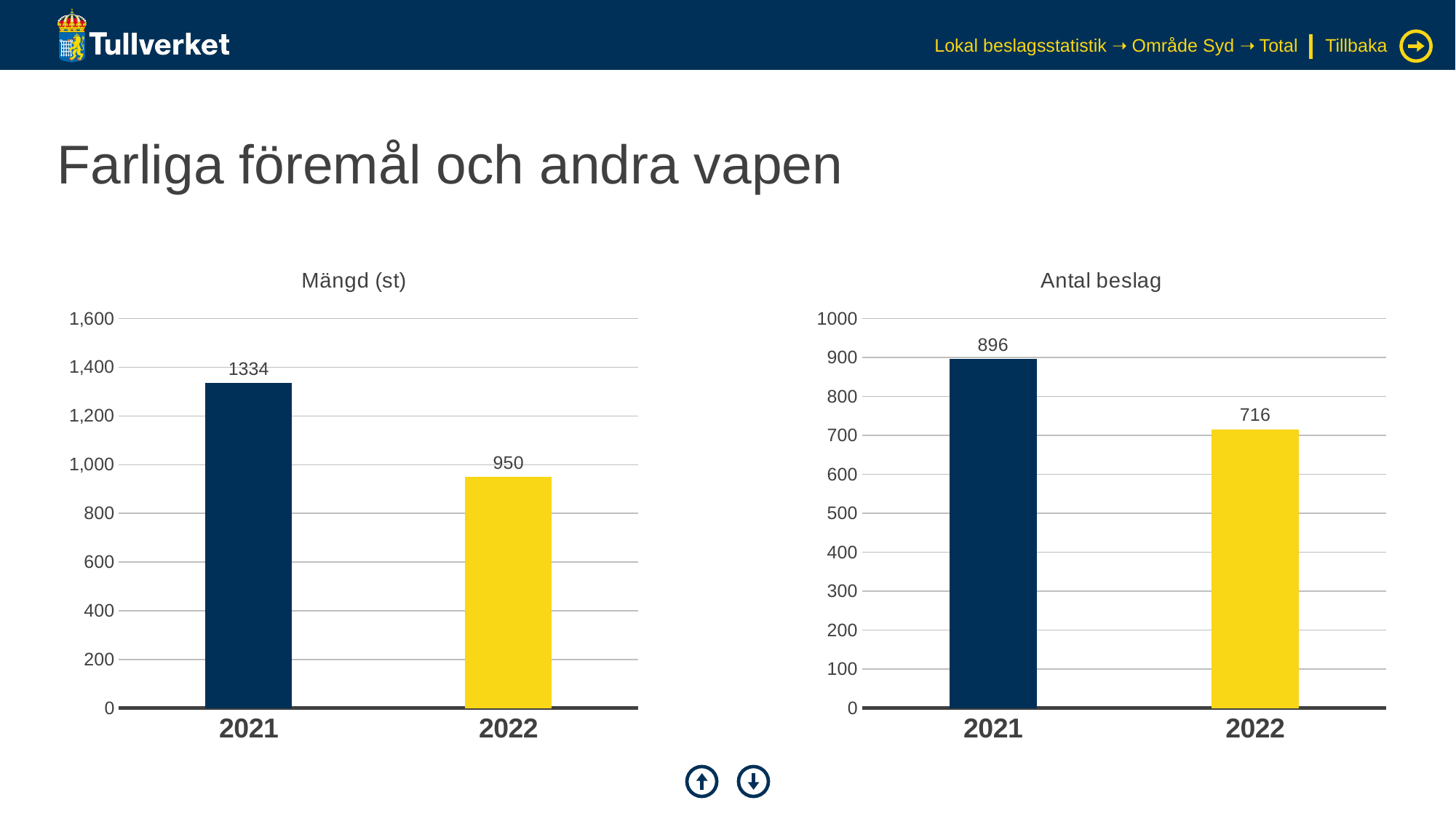
In the 'Mängd (st)' chart, what is the value for 2022? 950 How many bars are shown in the 'Mängd (st)' chart? 2 In the 'Antal beslag' chart, what is the value for 2021? 896 In the 'Mängd (st)' chart, what is the value for 2021? 1334 In the 'Antal beslag' chart, what is the value for 2022? 716 In the 'Mängd (st)' chart, which year has the highest value? 2021 In the 'Antal beslag' chart, is the value for 2021 greater or less than 800? greater What kind of chart is the 'Antal beslag' chart? bar chart In the 'Mängd (st)' chart, what is the difference between the 2021 and 2022 values? 384 In the 'Antal beslag' chart, which year has the lowest value? 2022 In the 'Mängd (st)' chart, do the values rise or fall from 2021 to 2022? fall In the 'Antal beslag' chart, what is the difference between the 2021 and 2022 values? 180